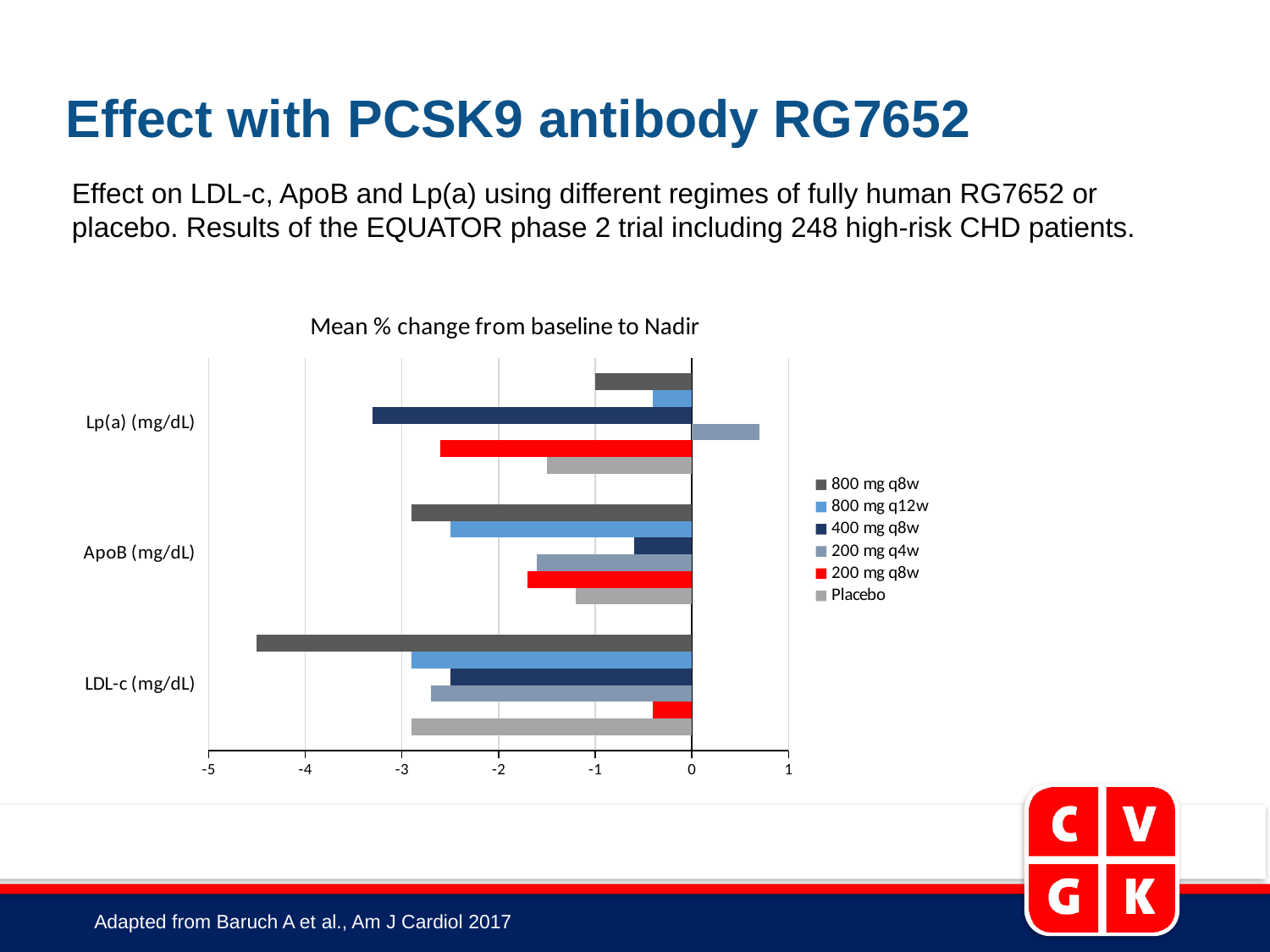
Is the value for 400 mg q8w in the Lp(a) (mg/dL) category greater or less than -3? less For the 800 mg q8w series, which category has the lowest (most negative) value? LDL-c (mg/dL) Is the value for 800 mg q12w in the Lp(a) (mg/dL) category greater or less than -1? greater Is the value for 800 mg q8w in the LDL-c (mg/dL) category greater or less than -4? less How many series does the legend list? 6 What is the title of the chart? Mean % change from baseline to Nadir What kind of chart is shown on the slide? Bar chart In the LDL-c (mg/dL) category, which has the more negative value: 800 mg q8w or 200 mg q8w? 800 mg q8w How many categories are shown on the vertical axis of the chart? 3 Which series is shown in red in the legend? 200 mg q8w